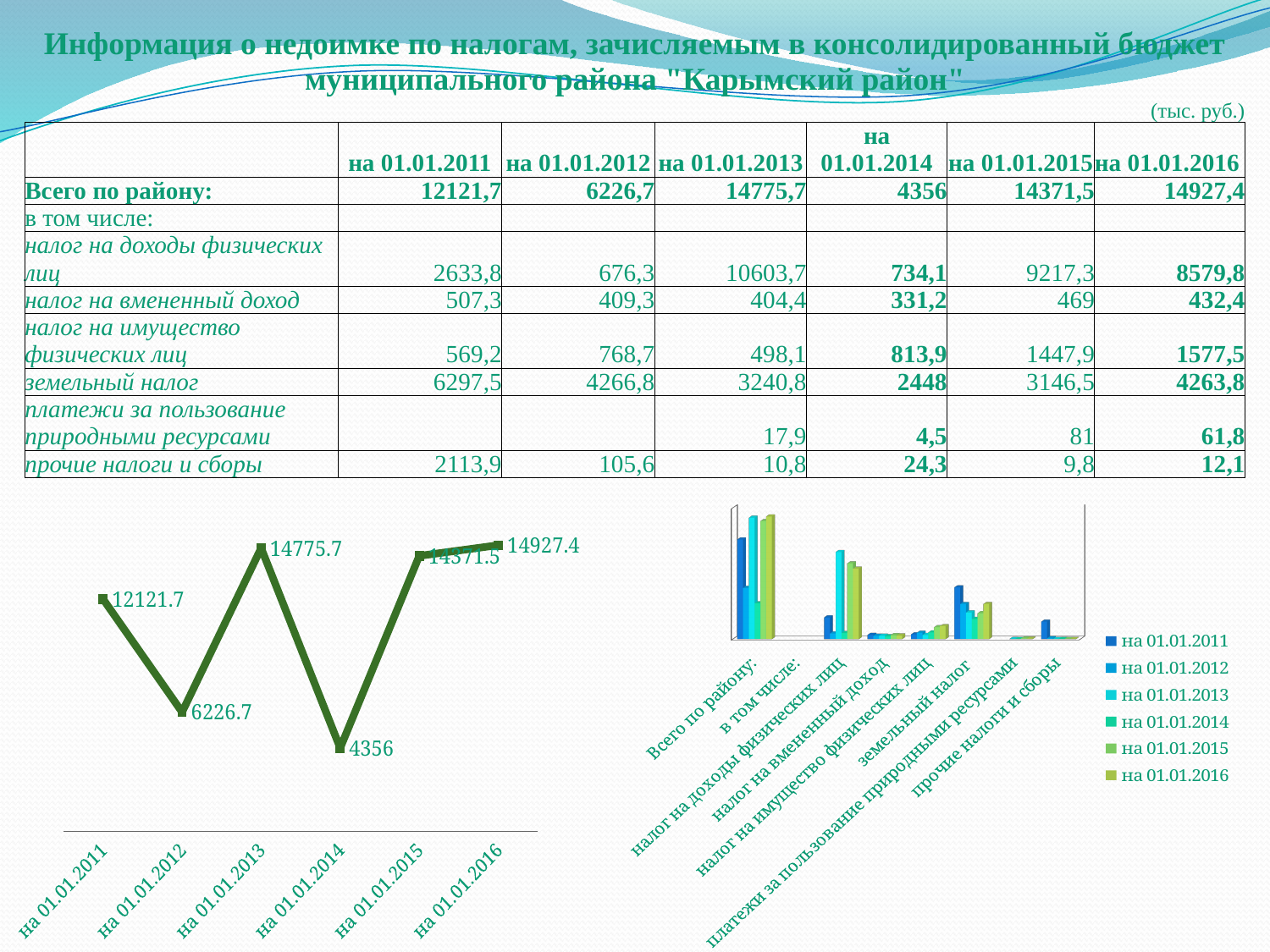
On the bar chart at the bottom right, how many series does the legend list? 6 On the line chart at the bottom left, which date has the highest value? на 01.01.2016 On the line chart at the bottom left, how many data points are plotted? 6 On the line chart at the bottom left, does the value rise or fall from на 01.01.2014 to на 01.01.2015? rise What kind of chart is shown at the bottom left of the slide? line chart On the line chart at the bottom left, what is the difference between the values for на 01.01.2013 and на 01.01.2014? 10419.7 On the line chart at the bottom left, what is the value for на 01.01.2013? 14775.7 On the line chart at the bottom left, what is the value for на 01.01.2014? 4356 On the line chart at the bottom left, which date has the lowest value? на 01.01.2014 On the line chart at the bottom left, which is larger: the value for на 01.01.2011 or the value for на 01.01.2012? на 01.01.2011 What kind of chart is shown at the bottom right of the slide? bar chart On the line chart at the bottom left, what is the value for на 01.01.2011? 12121.7